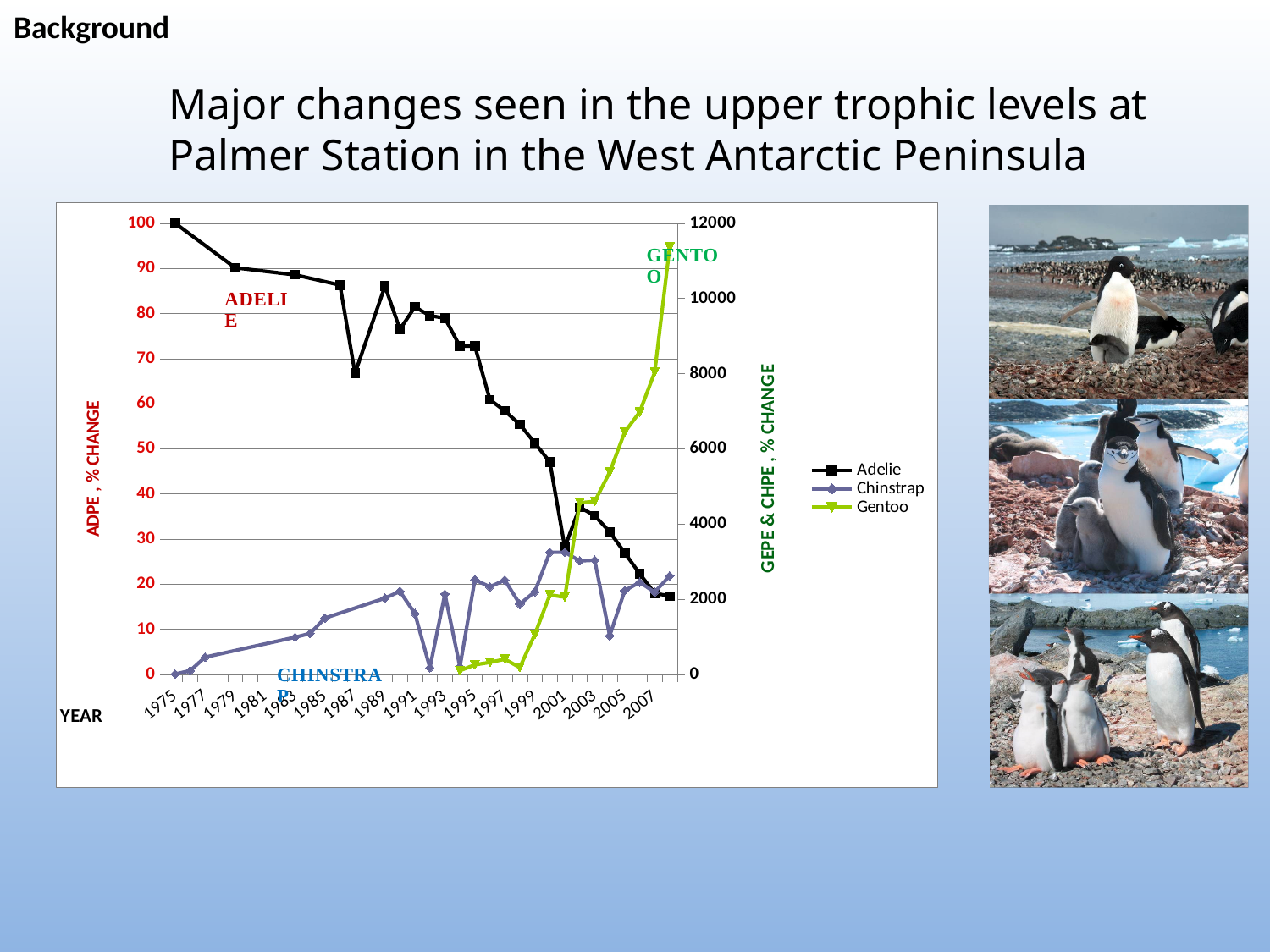
What is the value of the Adelie series in 1975 on the left axis? 100 Is the value for Gentoo in 2008 greater or less than 10000? greater Is the value for Adelie in 1987 greater or less than 60? greater At the end of the series in 2008, which is larger on the right axis, Gentoo or Chinstrap? Gentoo Is the value for Chinstrap in 2008 greater or less than 2000? greater Does the Gentoo series rise or fall from the mid-1990s to 2008? rise What is the title of the left vertical axis? ADPE , % CHANGE What are the three series named in the chart legend? Adelie, Chinstrap, Gentoo Does the Adelie series generally rise or fall from 1975 to 2007? fall How many series does the chart legend list? 3 What kind of chart is shown on the slide? line chart